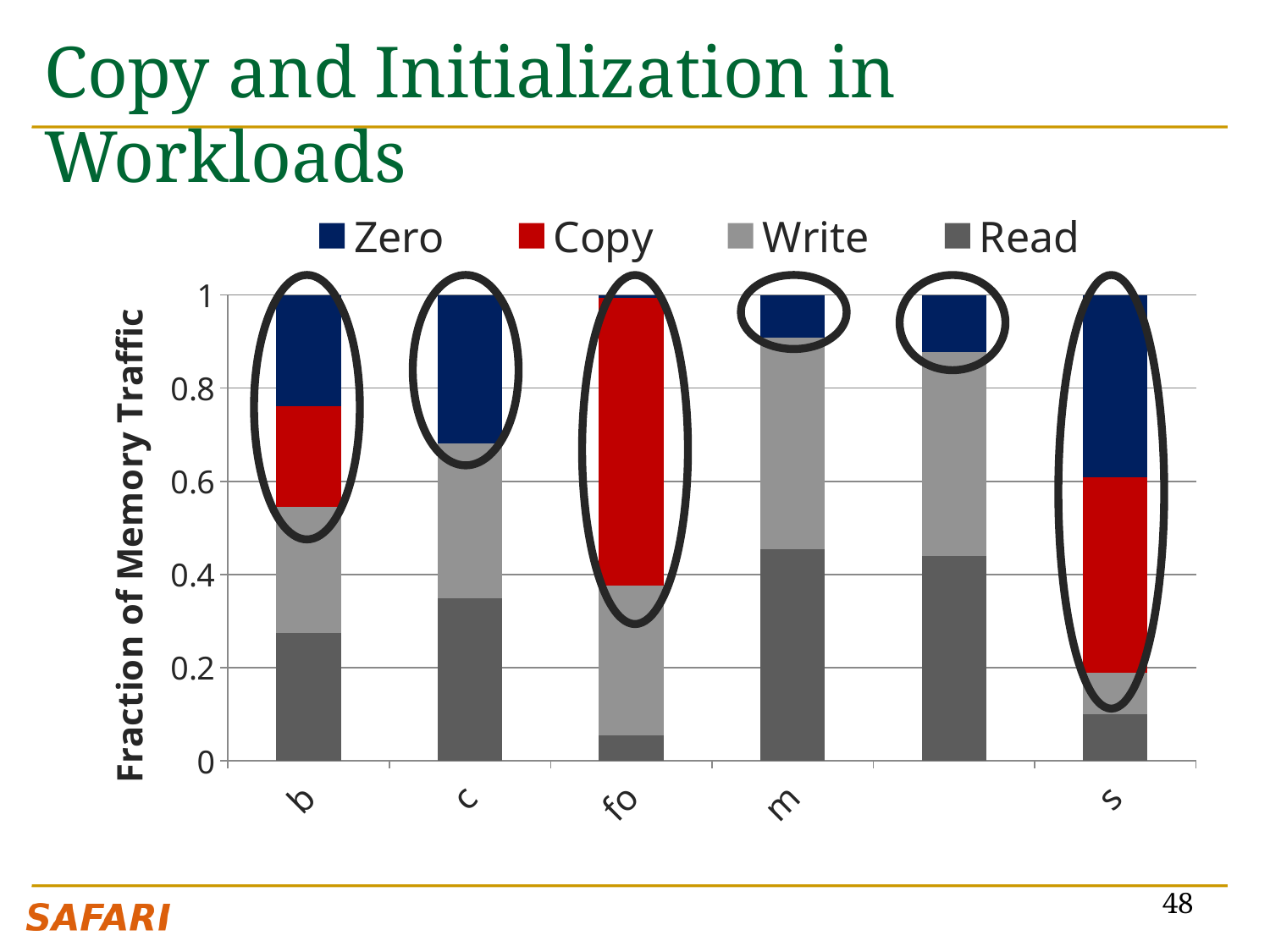
Which is larger, the Read value for workload m or the Read value for workload c? m How many series does the legend list? 4 Which workload has the smallest Read segment? fo What kind of chart is shown on the slide? Stacked bar chart Is the Read value for workload b greater or less than 0.2? greater Which series is shown in red in the legend? Copy Is the Read value for workload fo greater or less than 0.2? less Which workload has the largest Copy segment? fo Is the Read value for workload m greater or less than 0.4? greater What is the label of the y axis? Fraction of Memory Traffic How many bars are plotted in the chart? 6